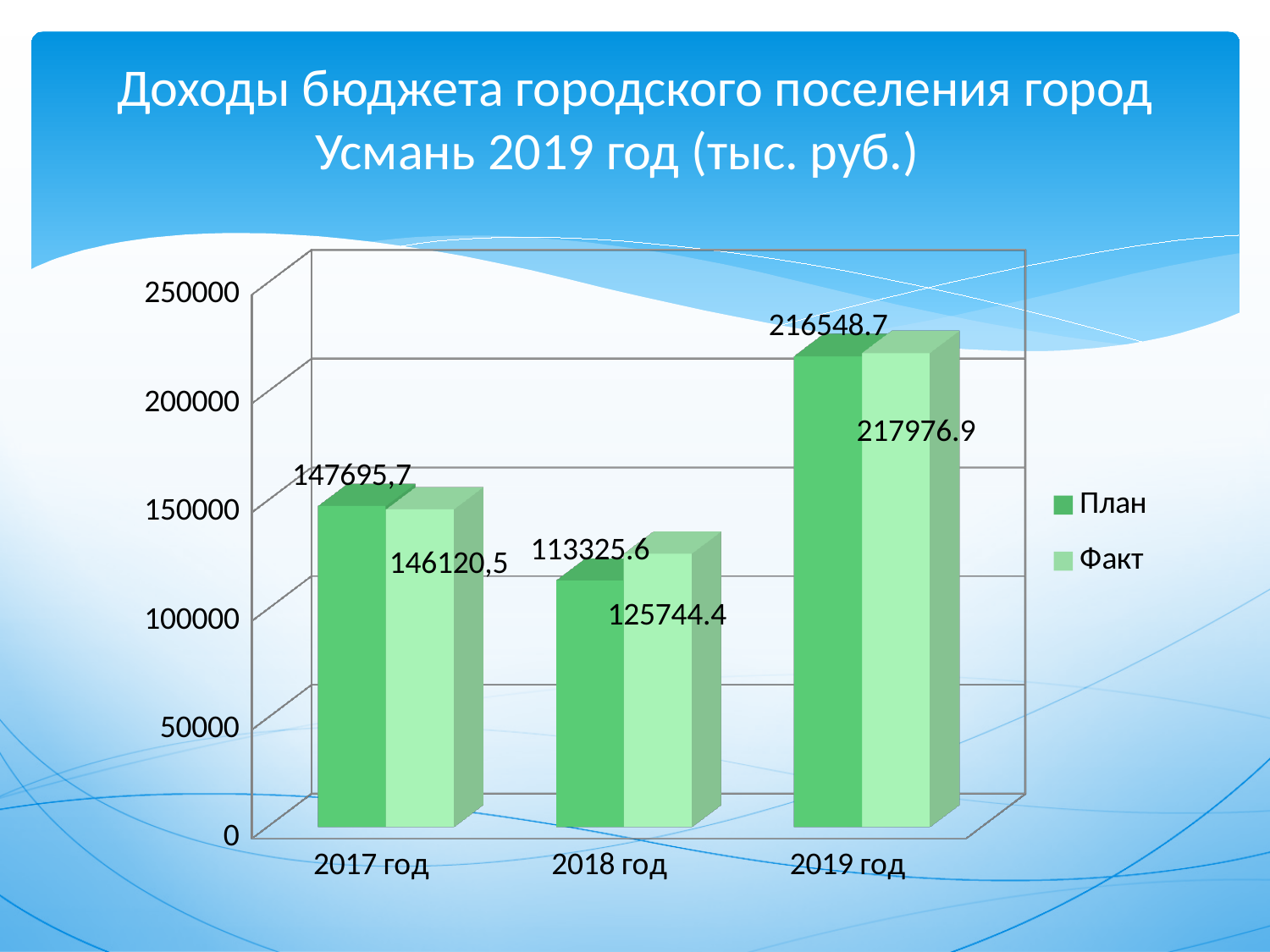
In which year is the Факт value the lowest? 2018 год What kind of chart is shown on the slide? bar chart What is the difference between the Факт and План values for 2018 год? 12418.8 What is the Факт value for 2017 год? 146120,5 For 2018 год, which is larger: План or Факт? Факт What is the План value for 2018 год? 113325.6 What is the План value for 2019 год? 216548.7 Is the Факт value for 2018 год greater or less than 100000? greater How many series does the legend list? 2 How many years are shown on the x axis? 3 What is the Факт value for 2019 год? 217976.9 In which year is the План value the highest? 2019 год